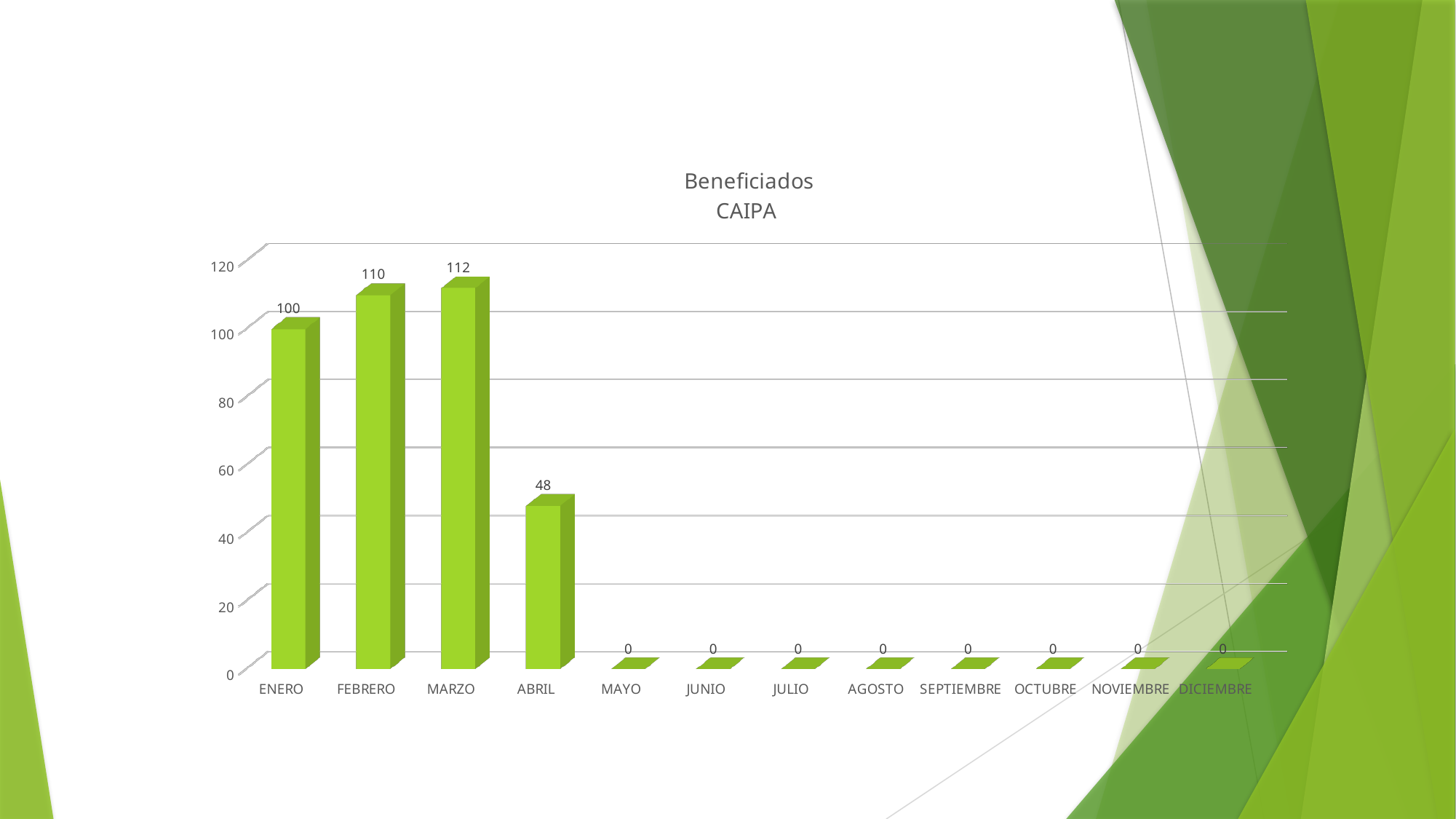
What kind of chart is shown? bar chart What is the title of the chart? Beneficiados CAIPA What is the difference between the values for MARZO and ABRIL? 64 Which month has the highest value? MARZO What is the value for MAYO? 0 How many months have a value of 0? 8 What is the value for ABRIL? 48 Is the value for ABRIL greater or less than 60? less Which is larger, the value for FEBRERO or the value for ENERO? FEBRERO What is the value for ENERO? 100 How many months are shown on the x axis? 12 What is the value for FEBRERO? 110